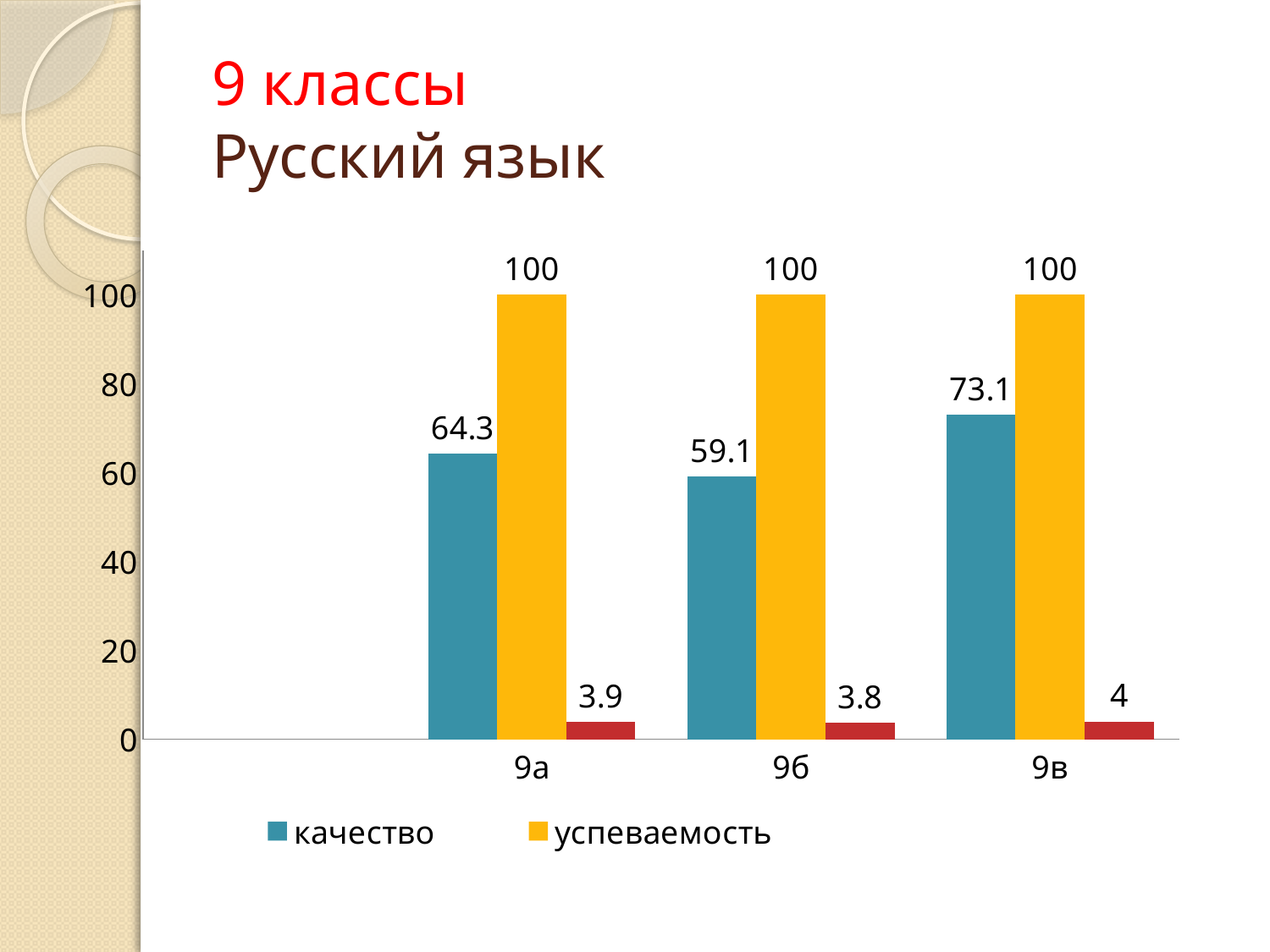
What is the difference between the качество values for 9в and 9б? 14 Which class has the lowest качество value? 9б What is the успеваемость value for 9б? 100 What is the качество value for 9а? 64.3 How many series does the legend list? 2 How many classes are shown on the x axis? 3 Which class has the highest качество value? 9в What kind of chart is shown on the slide? bar chart Is the качество value for 9в greater or less than 60? greater What is the качество value for 9в? 73.1 Which is larger, the качество value for 9а or for 9б? 9а What is the качество value for 9б? 59.1